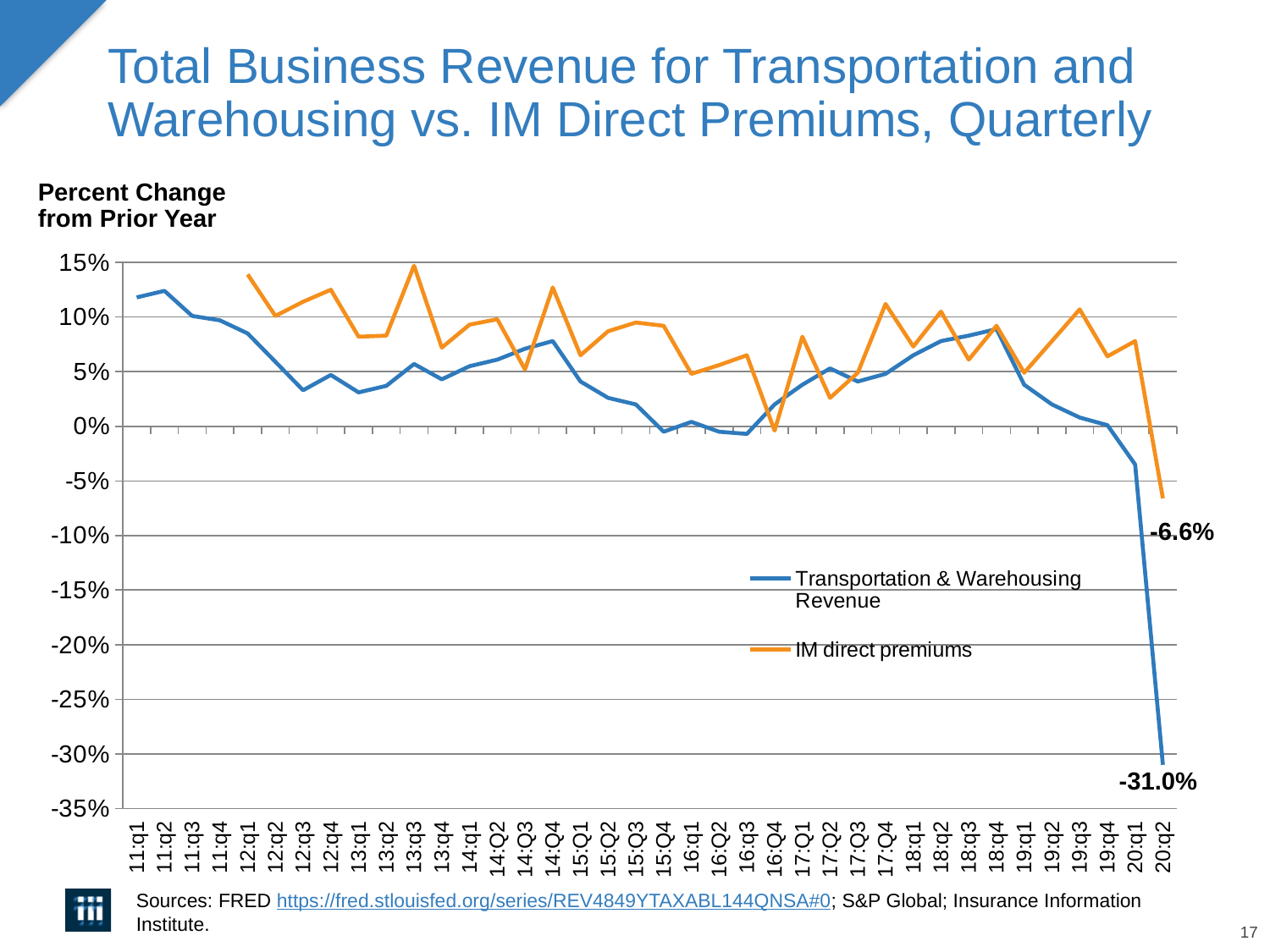
How many series does the legend list? 2 In which quarter does the Transportation & Warehousing Revenue series reach its lowest value? 20:q2 What is the difference between the IM direct premiums value and the Transportation & Warehousing Revenue value in 20:q2? 24.4 percentage points Is the value for Transportation & Warehousing Revenue in 11:q1 greater or less than 10%? greater Is the value for Transportation & Warehousing Revenue in 12:q3 greater or less than 5%? less Is the value for IM direct premiums in 13:q3 greater or less than 10%? greater What is the value for Transportation & Warehousing Revenue in 20:q2? -31.0% What type of chart is shown on the slide? Line chart What does the y-axis of the chart measure, according to the label above it? Percent Change from Prior Year In 20:q2, which series has the higher value, Transportation & Warehousing Revenue or IM direct premiums? IM direct premiums Does the Transportation & Warehousing Revenue line rise or fall from 19:q4 to 20:q2? Fall What is the value for IM direct premiums in 20:q2? -6.6%